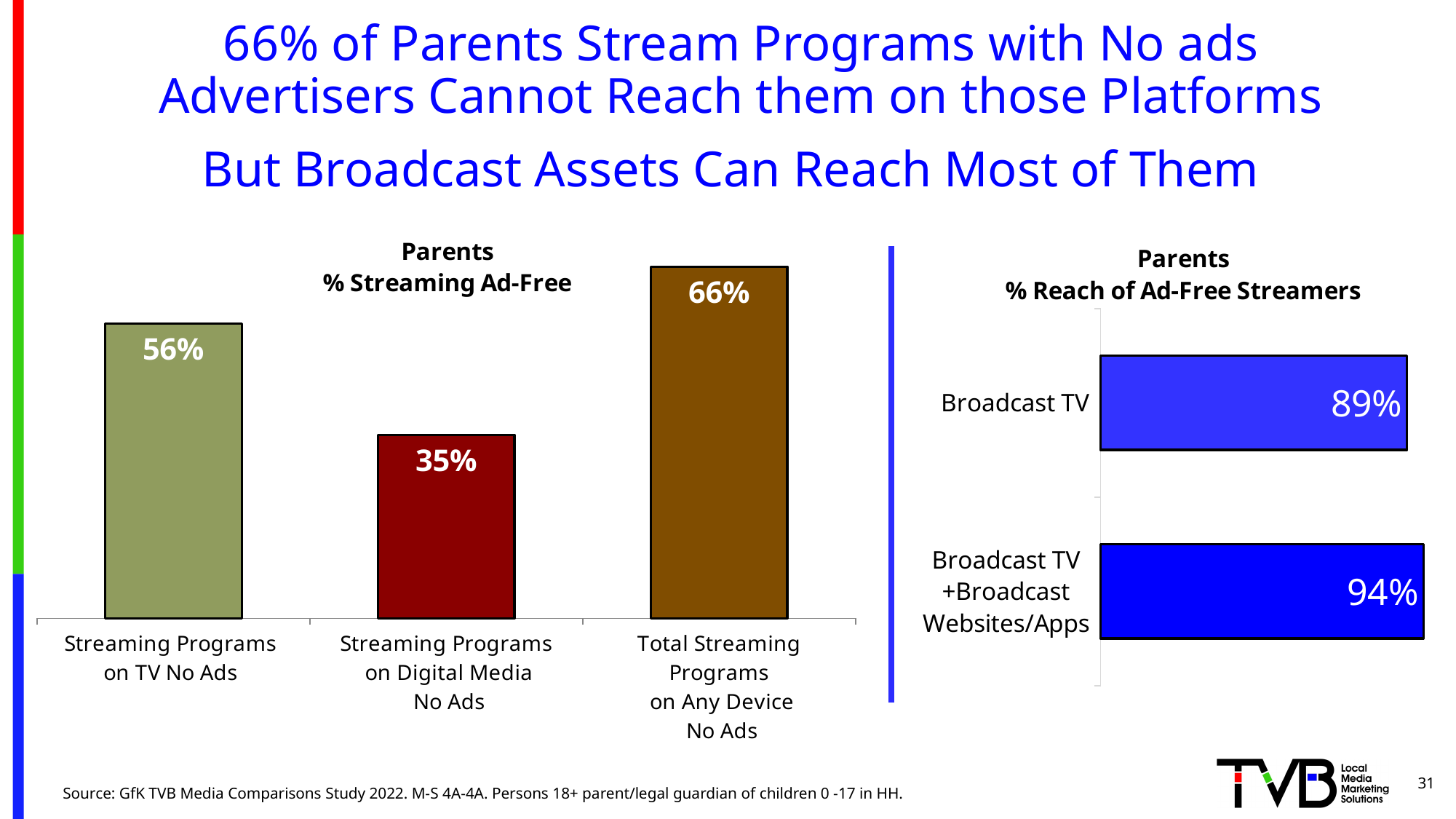
In the 'Parents % Streaming Ad-Free' chart, which category has the lowest value? Streaming Programs on Digital Media No Ads In the 'Parents % Streaming Ad-Free' chart, which category has the highest value? Total Streaming Programs on Any Device No Ads What kind of chart is the 'Parents % Reach of Ad-Free Streamers' chart? Bar chart In the 'Parents % Streaming Ad-Free' chart, what is the value for Total Streaming Programs on Any Device No Ads? 66% In the 'Parents % Streaming Ad-Free' chart, what is the difference between Streaming Programs on TV No Ads and Streaming Programs on Digital Media No Ads? 21% In the 'Parents % Reach of Ad-Free Streamers' chart, which is larger: Broadcast TV or Broadcast TV +Broadcast Websites/Apps? Broadcast TV +Broadcast Websites/Apps In the 'Parents % Reach of Ad-Free Streamers' chart, what is the difference between Broadcast TV +Broadcast Websites/Apps and Broadcast TV? 5% In the 'Parents % Streaming Ad-Free' chart, what is the value for Streaming Programs on Digital Media No Ads? 35% In the 'Parents % Reach of Ad-Free Streamers' chart, what is the value for Broadcast TV +Broadcast Websites/Apps? 94% In the 'Parents % Reach of Ad-Free Streamers' chart, what is the value for Broadcast TV? 89% In the 'Parents % Streaming Ad-Free' chart, how many categories are shown? 3 In the 'Parents % Streaming Ad-Free' chart, what is the value for Streaming Programs on TV No Ads? 56%